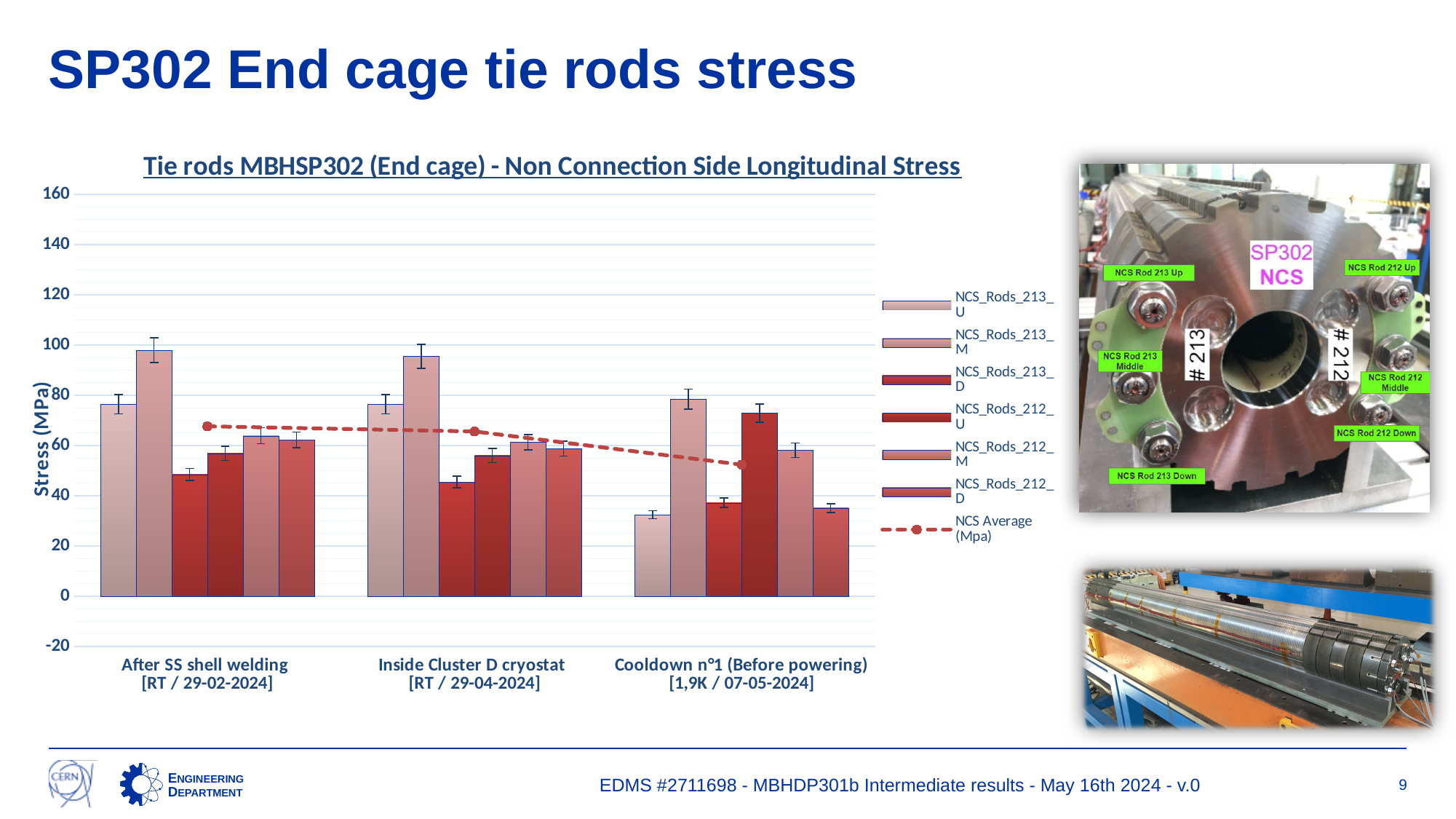
Is the value for NCS_Rods_212_U at Cooldown n°1 (Before powering) greater or less than 60? greater Inside Cluster D cryostat, which is larger: NCS_Rods_213_U or NCS_Rods_213_M? NCS_Rods_213_M Does the NCS Average line rise or fall from the first stage to the last stage? fall What kind of chart is shown on the slide? combination bar and line chart Is the value for NCS_Rods_213_U at Cooldown n°1 (Before powering) greater or less than 40? less How many entries does the legend list? 7 Which series has the lowest stress after SS shell welding? NCS_Rods_213_D What is the label of the vertical axis? Stress (MPa) Which series has the highest stress after SS shell welding? NCS_Rods_213_M Is the value for NCS_Rods_213_M after SS shell welding greater or less than 80? greater How many measurement stages (categories) are shown along the x axis? 3